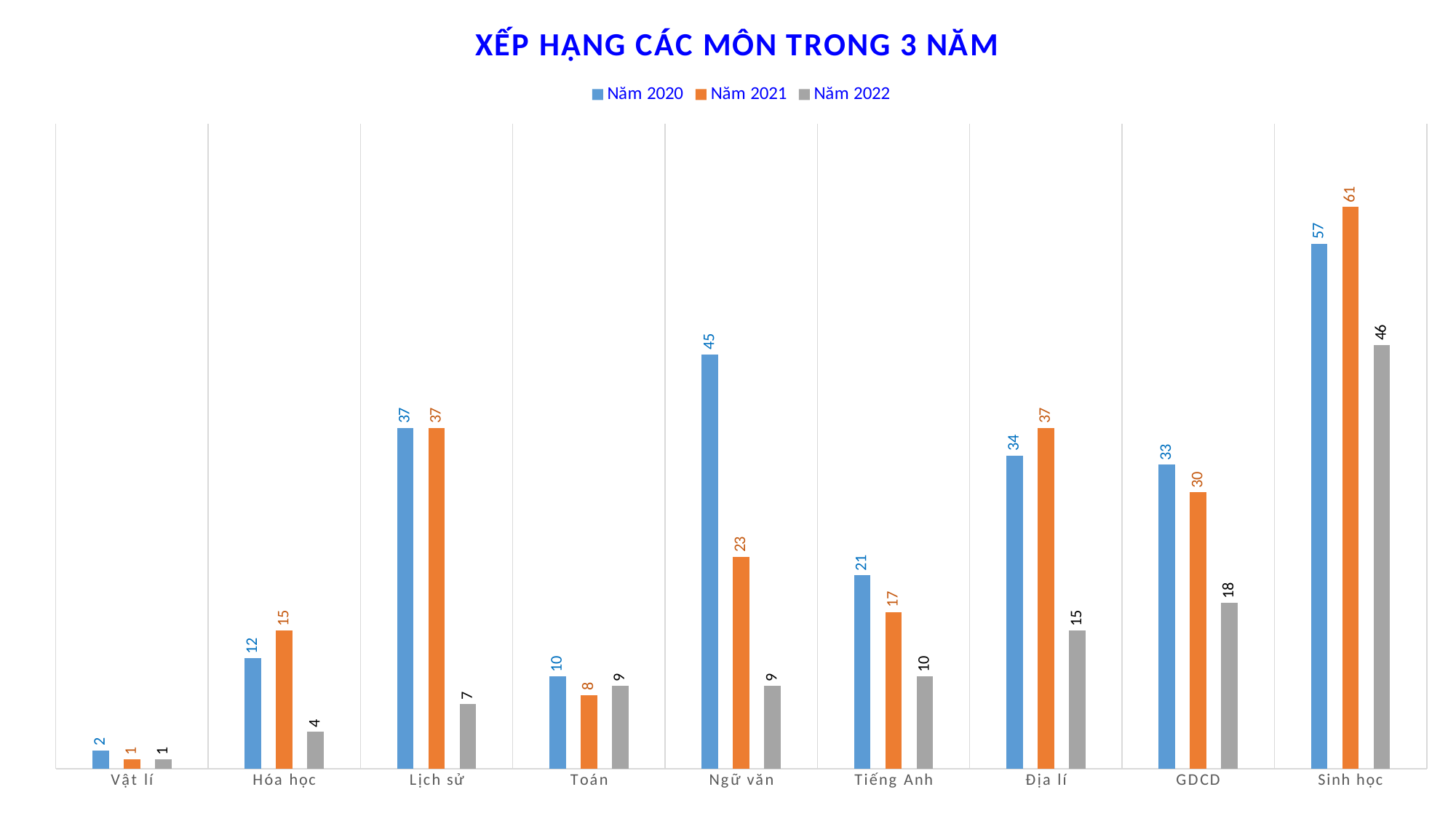
Which category has the lowest value in Năm 2022? Vật lí What is the value for GDCD in Năm 2021? 30 Which colour represents Năm 2022 in the legend? Grey How many series does the legend list? 3 What kind of chart is this? Bar chart What is the value for Sinh học in Năm 2022? 46 How many categories are shown on the x axis? 9 What is the title of the chart? XẾP HẠNG CÁC MÔN TRONG 3 NĂM Which category has the highest value in Năm 2021? Sinh học What is the value for Ngữ văn in Năm 2020? 45 Which is larger for Địa lí: the Năm 2020 value or the Năm 2021 value? Năm 2021 What is the difference between the Năm 2020 and Năm 2022 values for Ngữ văn? 36